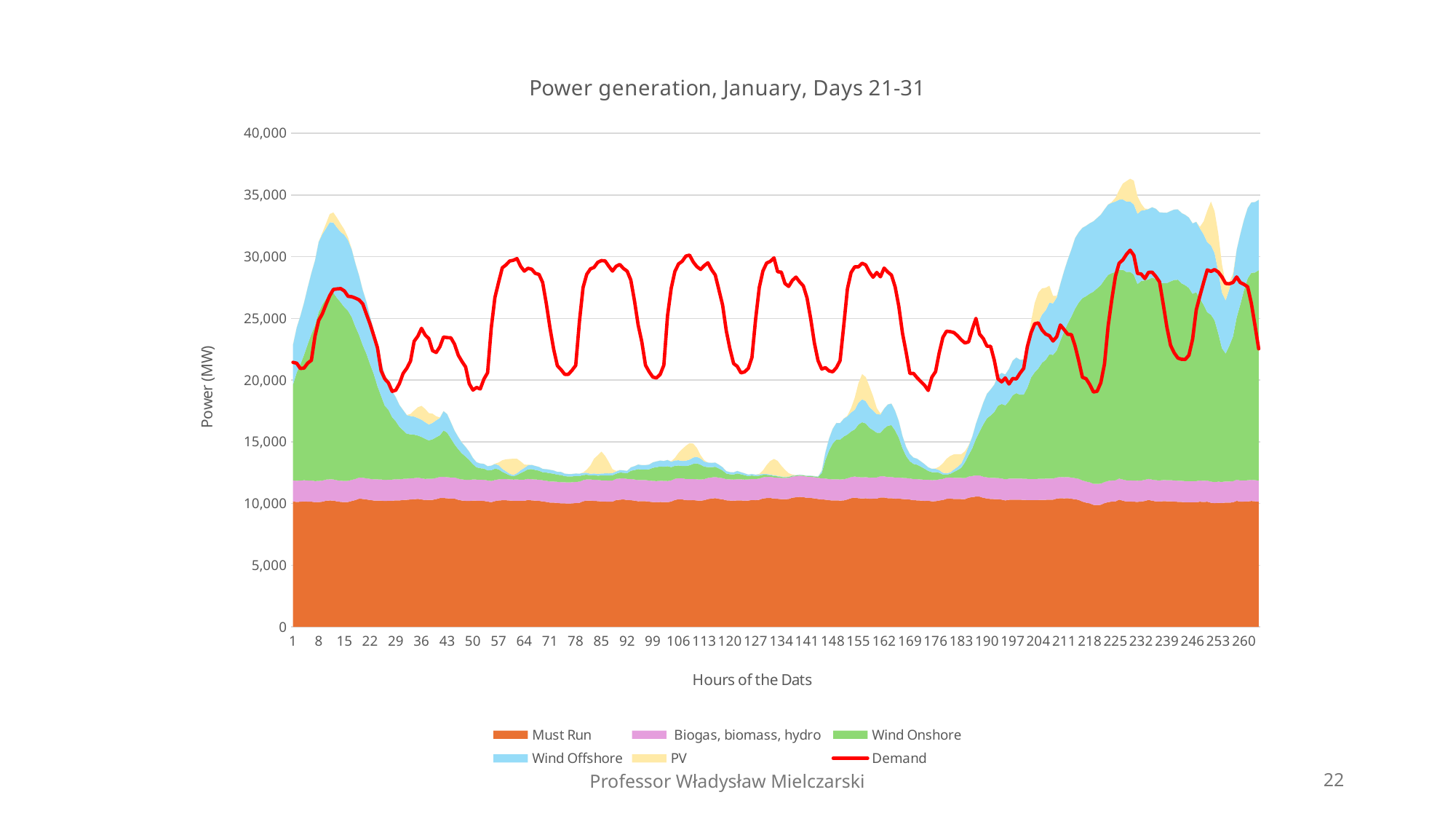
Is the Demand value at hour 64 greater or less than 25,000? greater Is the Must Run value at hour 99 greater or less than 15,000? less Which series is drawn as a red line rather than a filled area? Demand At hour 106, which is larger: Demand or the total stacked generation? Demand Is the total stacked generation at hour 85 greater or less than 20,000? less What is the title of the chart? Power generation, January, Days 21-31 What kind of chart is this? Stacked area chart with a line series At hour 232, which is larger: Demand or the total stacked generation? Total stacked generation How many series does the legend list? 6 What is the label of the vertical axis? Power (MW)